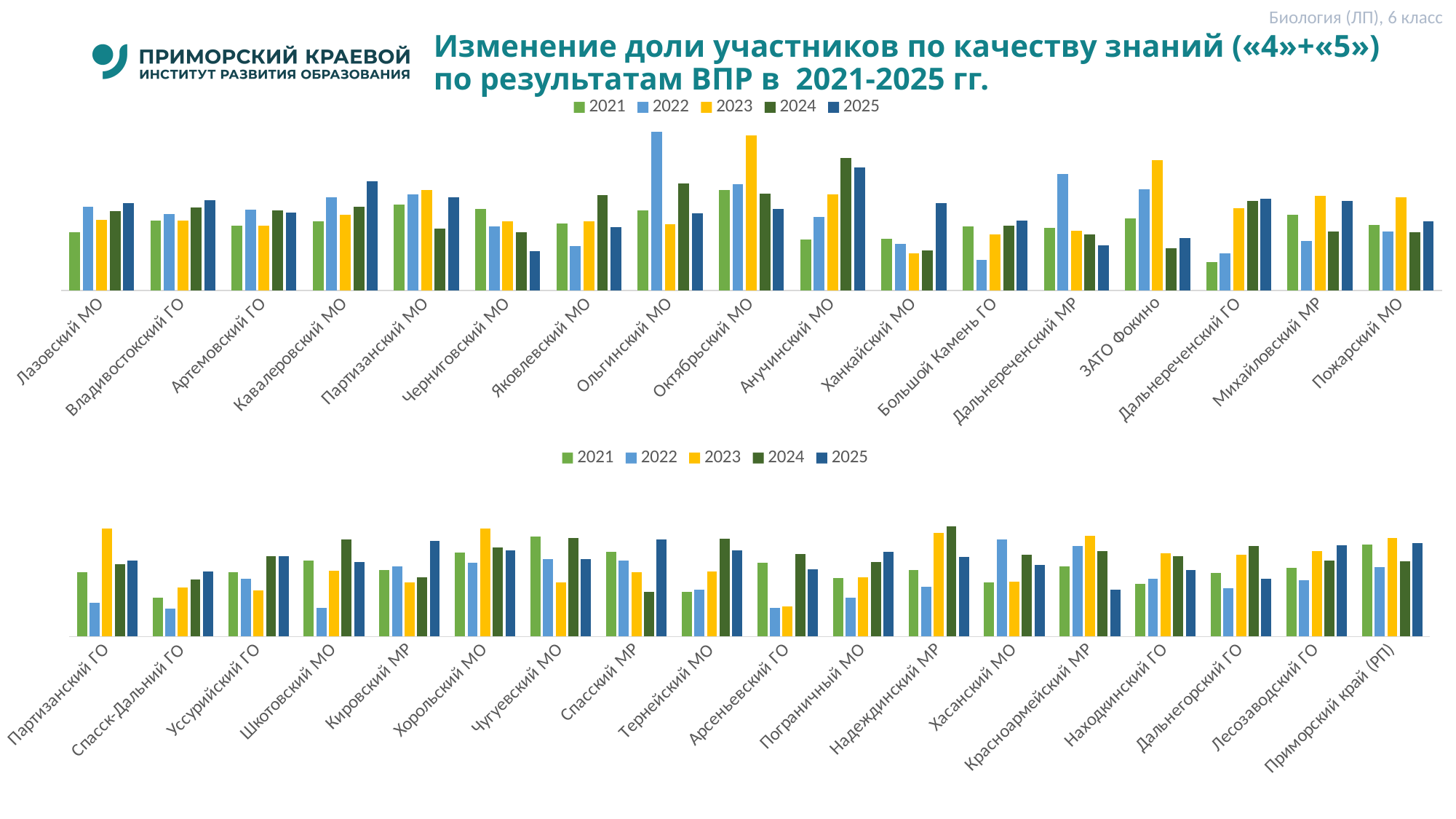
In the bottom chart, which year has the highest bar for Партизанский ГО? 2023 How many series does the legend of the top chart list? 5 What kind of chart is the top chart on the slide? bar chart Which year is shown in yellow in the legend of the charts? 2023 In the top chart, which year has the highest bar for Ольгинский МО? 2022 How many categories are shown on the x axis of the top chart? 17 In the bottom chart, which year has the lowest bar for Спасск-Дальний ГО? 2022 In the top chart, which year has the lowest bar for Дальнереченский ГО? 2021 In the top chart, which year has the highest bar for Октябрьский МО? 2023 In the top chart, for Ольгинский МО, which is larger: the 2022 bar or the 2023 bar? 2022 How many categories are shown on the x axis of the bottom chart? 18 In the bottom chart, for Чугуевский МО, which is larger: the 2021 bar or the 2023 bar? 2021